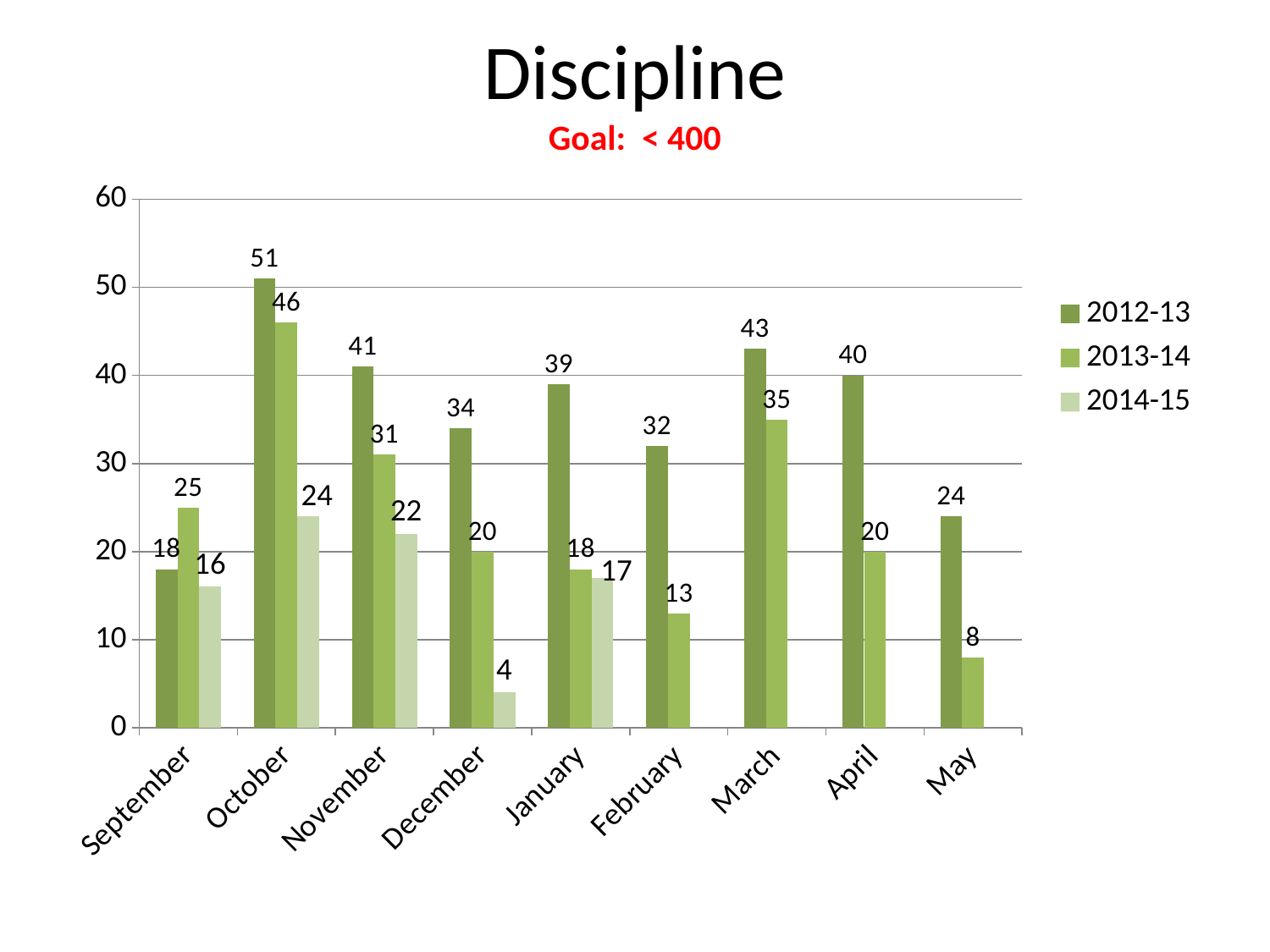
What goal is stated below the chart title? Goal: < 400 What is the difference between the 2012-13 and 2013-14 values in November? 10 What kind of chart is shown on the slide? bar chart What is the value for 2012-13 in October? 51 How many months are shown on the x axis? 9 What is the value for 2013-14 in March? 35 What is the title of the chart? Discipline What is the value for 2014-15 in December? 4 How many series does the legend list? 3 Which month has the highest value for the 2012-13 series? October Which month has the lowest value for the 2013-14 series? May Which is larger in September: the 2012-13 value or the 2013-14 value? 2013-14